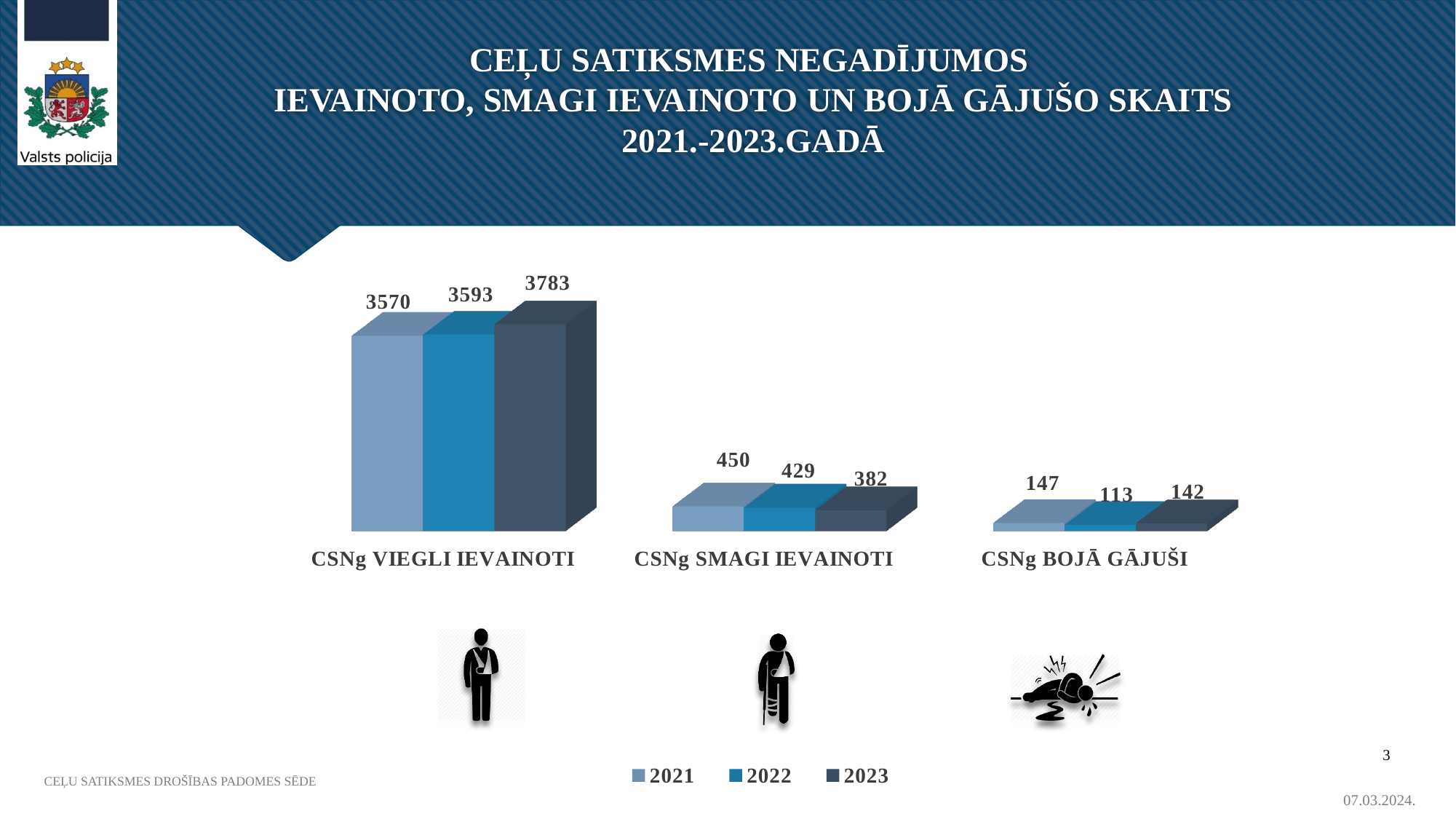
Which is larger: the 2021 value or the 2023 value for CSNg BOJĀ GĀJUŠI? 2021 What kind of chart is shown on the slide? bar chart How many series does the legend list? 3 What is the difference between the 2023 and 2021 values for CSNg VIEGLI IEVAINOTI? 213 Which year has the lowest value in the CSNg BOJĀ GĀJUŠI category? 2022 What is the value for 2022 in the CSNg BOJĀ GĀJUŠI category? 113 What is the value for 2023 in the CSNg VIEGLI IEVAINOTI category? 3783 What is the value for 2021 in the CSNg SMAGI IEVAINOTI category? 450 How many categories are shown on the x axis? 3 Which year has the highest value in the CSNg VIEGLI IEVAINOTI category? 2023 What is the difference between the 2021 and 2023 values for CSNg SMAGI IEVAINOTI? 68 Do the values for CSNg SMAGI IEVAINOTI rise or fall from 2021 to 2023? fall